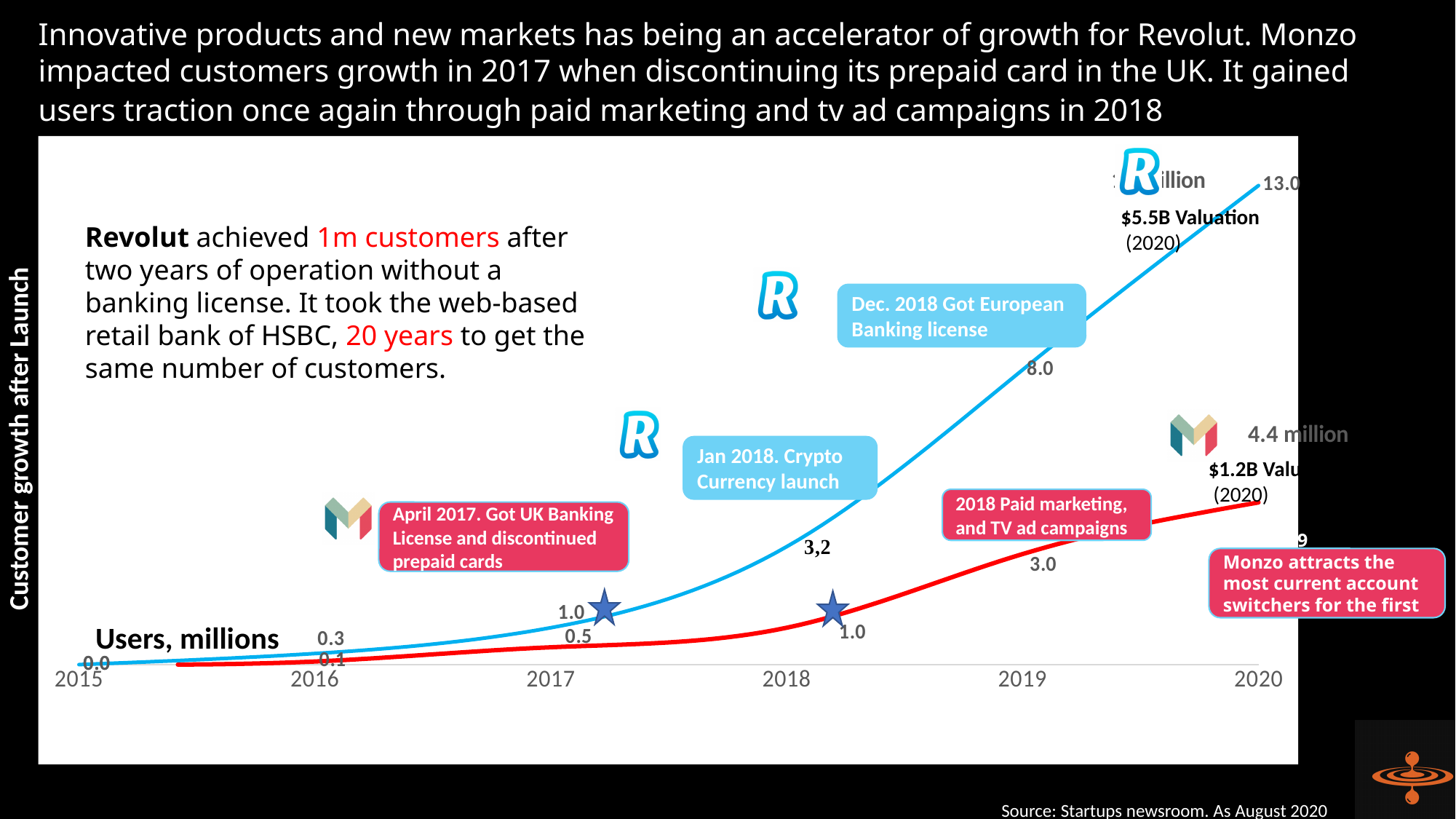
What is the value labelled on the blue Revolut line at 2016? 0.3 What is the value labelled on the red Monzo line at 2017? 0.5 What is the difference between the Revolut value at 2020 (13.0) and the Revolut value at 2019 (8.0)? 5.0 What is the value labelled on the blue Revolut line at 2019? 8.0 What unit is stated for the values plotted on the chart? Users, millions At 2019, which line has the higher value, the blue Revolut line or the red Monzo line? blue Revolut line What is the difference between the Revolut value at 2019 (8.0) and the Monzo value at 2019 (3.0)? 5.0 What is the value labelled on the blue Revolut line at 2020? 13.0 How many year labels are shown on the x axis? 6 What type of chart is shown on the slide? line chart Does the blue Revolut line rise or fall from 2015 to 2020? rise What is the value labelled on the red Monzo line at 2019? 3.0